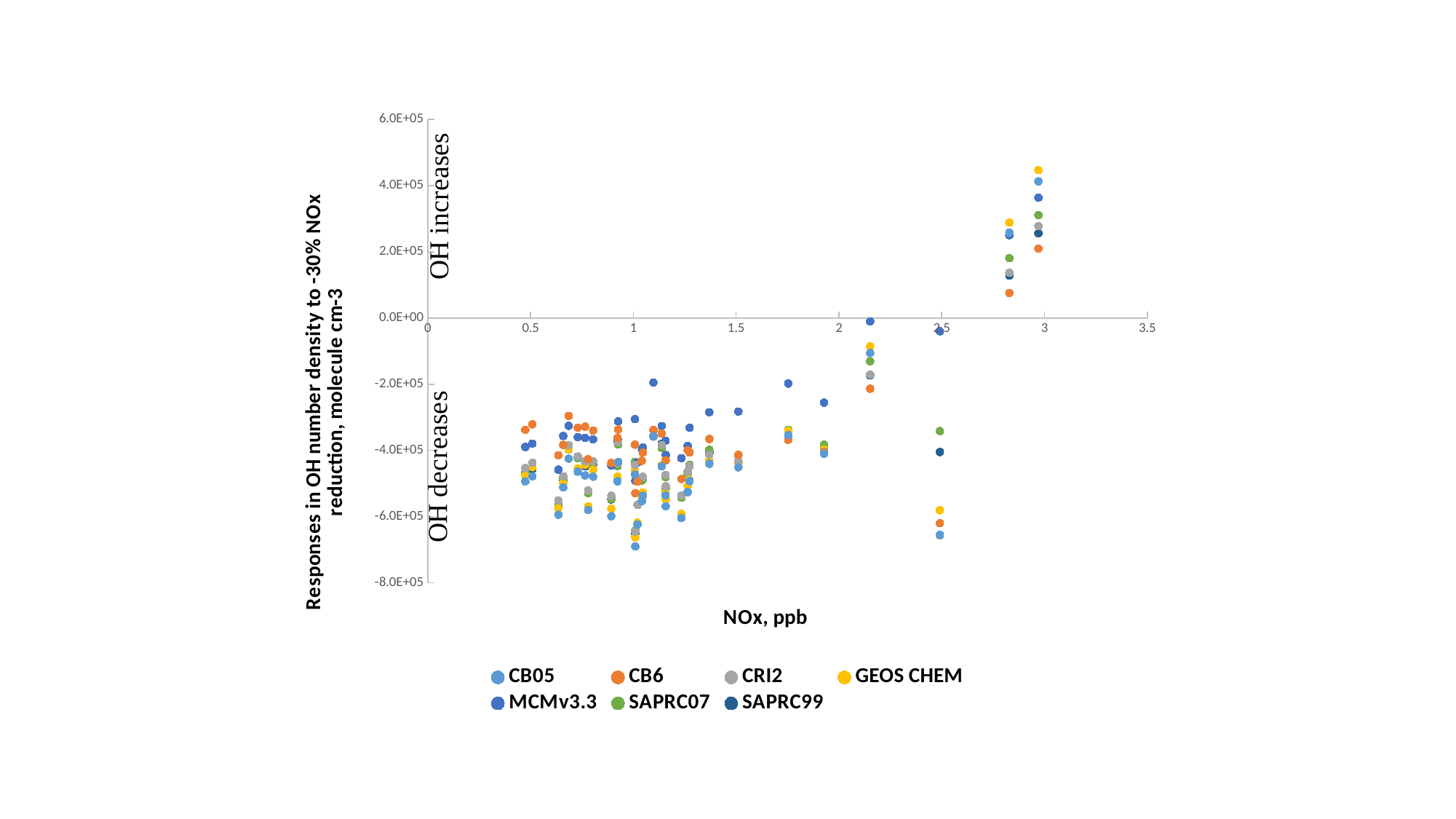
Is the highest GEOS CHEM point (at NOx of about 3 ppb) greater or less than 4.0E+05? greater How many series does the legend list? 7 At NOx of about 3 ppb, which series has the larger value, GEOS CHEM or CB6? GEOS CHEM Is the CB6 point at NOx of about 2.8 ppb greater or less than 2.0E+05? less Which series is shown in orange in the legend? CB6 Is the MCMv3.3 point at NOx of about 1.1 ppb greater or less than -4.0E+05? greater At NOx of about 2.5 ppb, which series has the larger value, SAPRC07 or CB05? SAPRC07 Do the plotted responses generally rise or fall as NOx increases along the x axis? rise What kind of chart is shown on the slide? scatter chart What is the title of the x axis? NOx, ppb Which series has the highest plotted point on the chart? GEOS CHEM